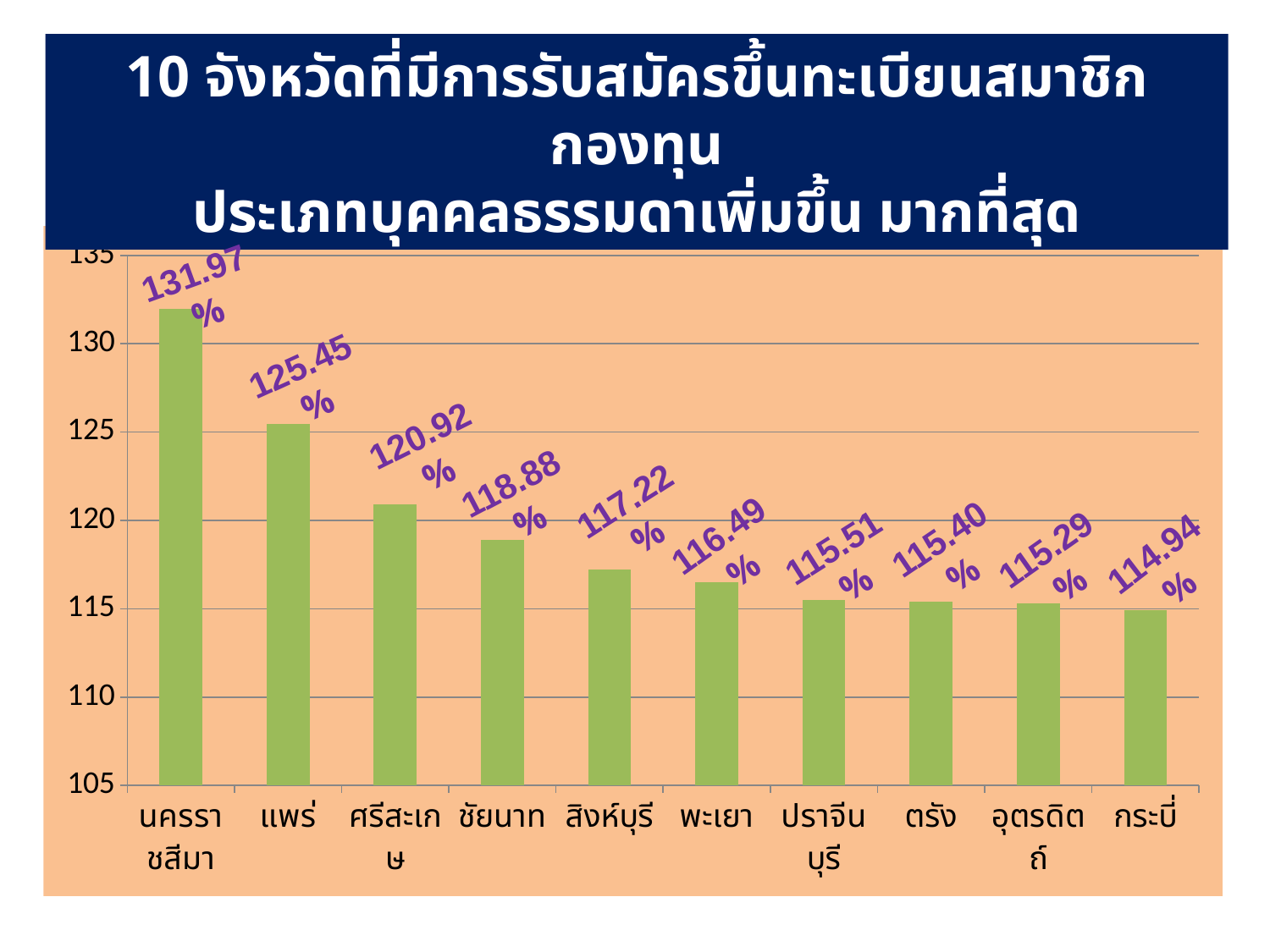
What is the value for นครราชสีมา? 131.97% What kind of chart is shown on the slide? bar chart What is the value for ตรัง? 115.40% How many provinces are shown in the chart? 10 What is the value for ชัยนาท? 118.88% Which province has the highest value? นครราชสีมา Which province has the lowest value? กระบี่ Is the value for แพร่ greater or less than 120? greater Do the values rise or fall from left to right along the x axis? fall What is the value for กระบี่? 114.94% What is the difference between the values for นครราชสีมา and แพร่? 6.52% Which is larger, the value for ศรีสะเกษ or the value for สิงห์บุรี? ศรีสะเกษ